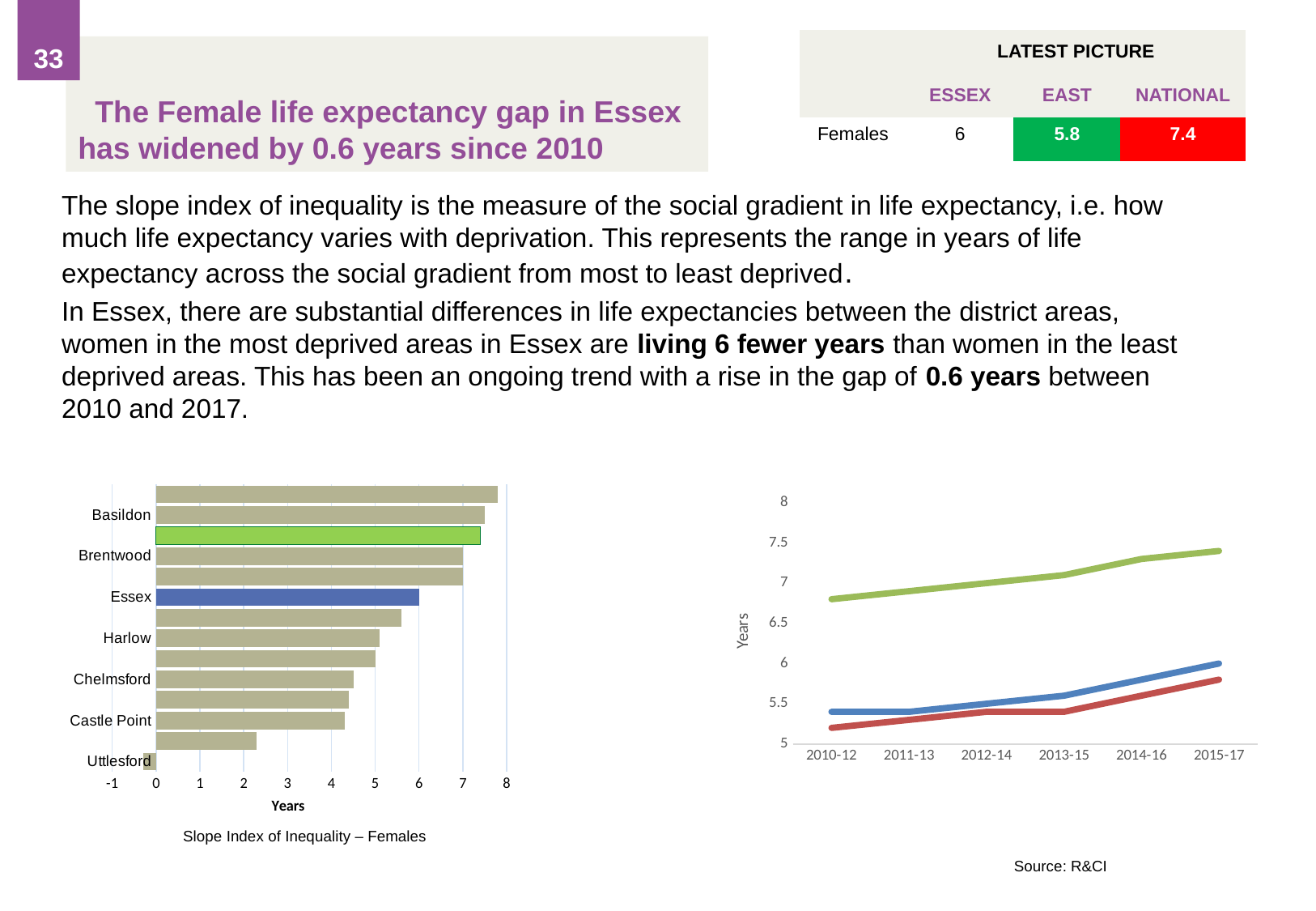
In the line chart on the right, does the green line rise or fall from 2010-12 to 2015-17? rises What kind of chart is the chart on the right of the slide? line chart In the line chart on the right, is the green line's value for 2015-17 greater or less than 7? greater In the line chart on the right, how many time periods are shown on the x axis? 6 In the Slope Index of Inequality – Females chart, what colour is the Essex bar? blue What kind of chart is the Slope Index of Inequality – Females chart on the left? bar chart In the Slope Index of Inequality – Females chart, which labelled district has the lowest value? Uttlesford In the Slope Index of Inequality – Females chart, is the value for Uttlesford greater or less than 0? less In the Slope Index of Inequality – Females chart, is the value for Basildon greater or less than 7? greater In the Slope Index of Inequality – Females chart, which is larger, the value for Basildon or the value for Harlow? Basildon In the Slope Index of Inequality – Females chart, what is the value for Essex? 6